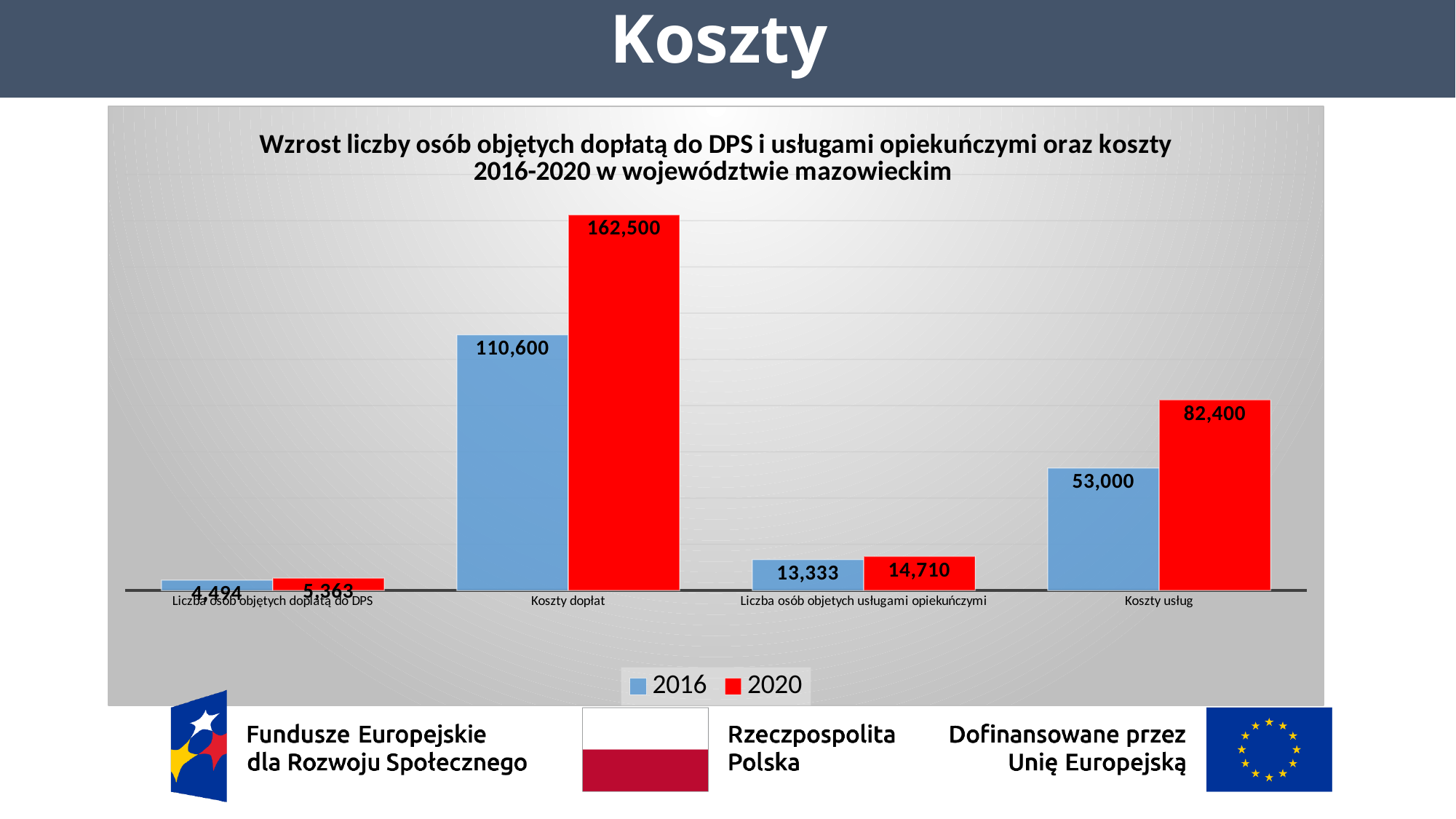
What is the 2016 value for Liczba osób objętych dopłatą do DPS? 4,494 Which is larger: the 2016 value for Koszty usług or the 2016 value for Koszty dopłat? Koszty dopłat How many series does the legend list? 2 What is the difference between the 2020 and 2016 values for Koszty usług? 29,400 Which category has the highest value in the 2020 series? Koszty dopłat What kind of chart is shown on the slide? Bar chart What is the difference between the 2020 and 2016 values for Koszty dopłat? 51,900 Which category has the lowest value in the 2016 series? Liczba osób objętych dopłatą do DPS What is the 2020 value for Liczba osób objętych usługami opiekuńczymi? 14,710 What is the value for Koszty dopłat in 2020? 162,500 What is the value for Koszty usług in 2016? 53,000 How many categories are shown on the x axis? 4